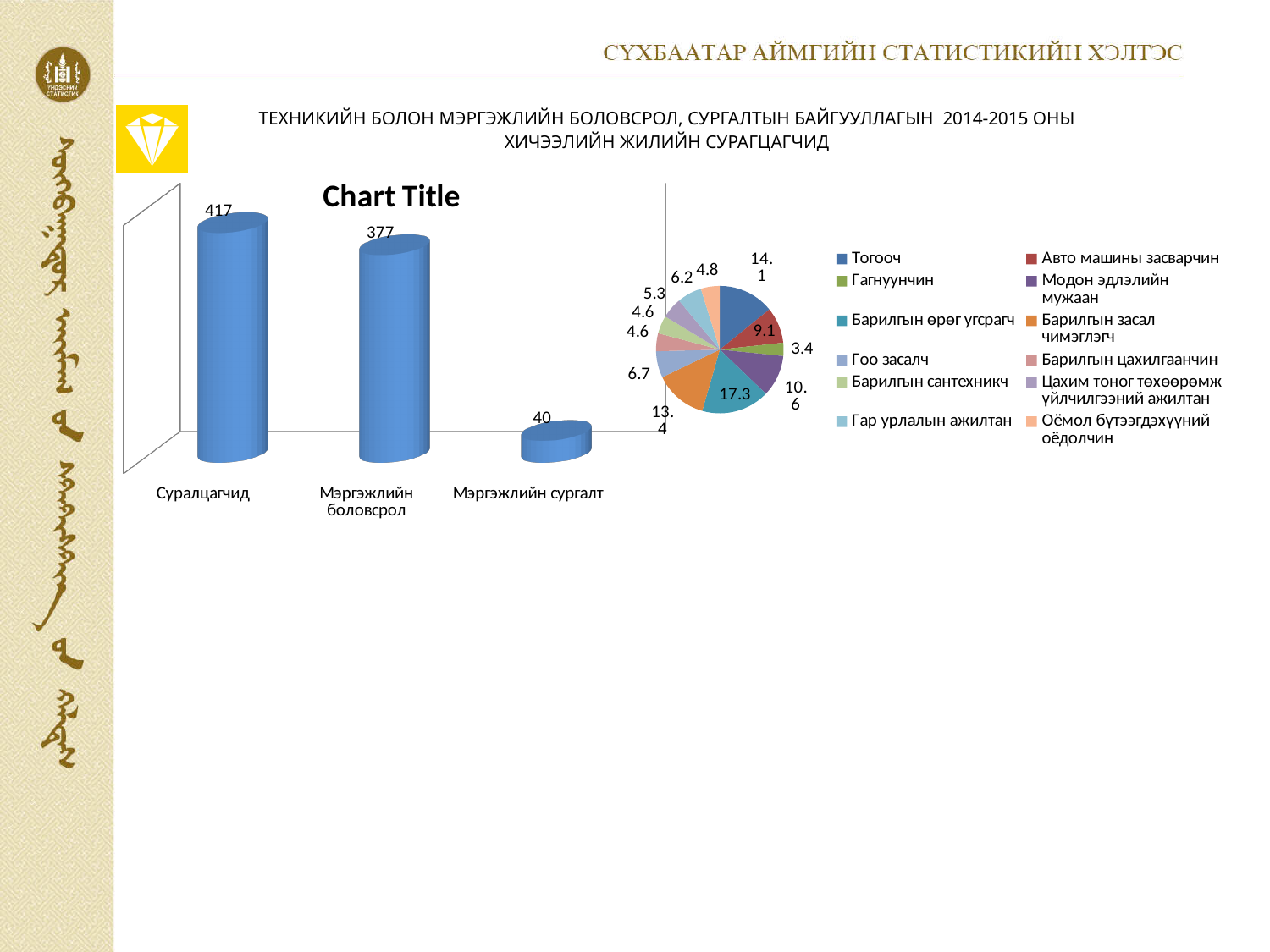
In the bar chart on the left, what is the value for Суралцагчид? 417 In the bar chart on the left, what is the difference between the values for Суралцагчид and Мэргэжлийн боловсрол? 40 How many entries does the legend of the pie chart on the right list? 12 In the bar chart on the left, how many categories are shown? 3 In the pie chart on the right, which category has the smallest slice? Гагнуунчин In the pie chart on the right, which category has the largest slice? Барилгын өрөг угсрагч In the bar chart on the left, which category has the lowest value? Мэргэжлийн сургалт In the pie chart on the right, what is the value shown for Тогооч? 14.1 In the bar chart on the left, what is the value for Мэргэжлийн боловсрол? 377 In the bar chart on the left, what is the value for Мэргэжлийн сургалт? 40 What kind of chart is the chart on the left of the slide? Bar chart In the bar chart on the left, which category has the highest value? Суралцагчид